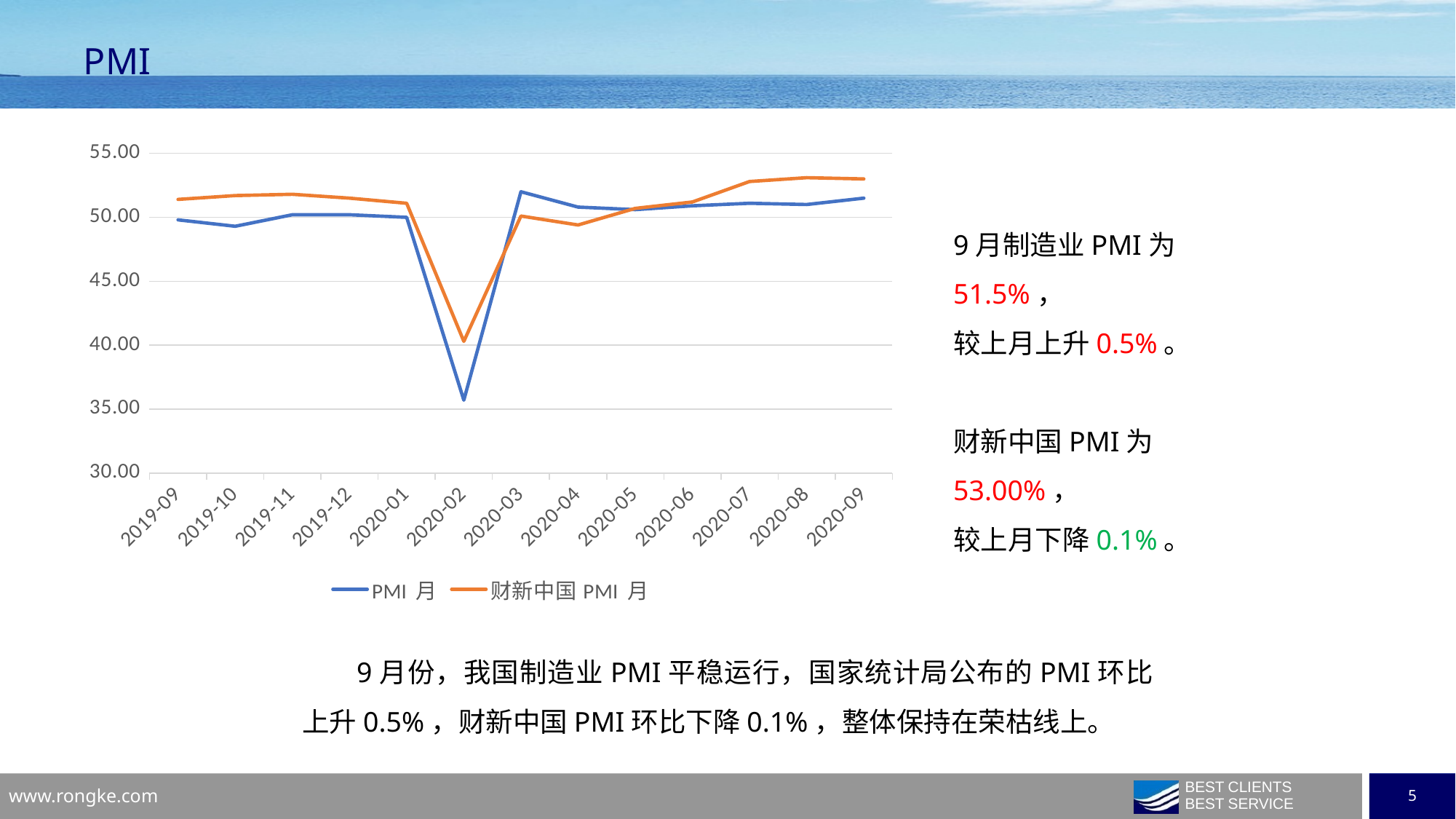
Is the value of 财新中国 PMI 月 in 2020-02 greater or less than 45.00? less Which month has the lowest value for the PMI 月 series? 2020-02 In 2020-02, which series has the higher value, PMI 月 or 财新中国 PMI 月? 财新中国 PMI 月 How many series does the chart legend list? 2 How many months are plotted along the x axis of the chart? 13 Which month has the lowest value for the 财新中国 PMI 月 series? 2020-02 Is the value of PMI 月 in 2019-10 greater or less than 50.00? less In 2020-04, which series has the higher value, PMI 月 or 财新中国 PMI 月? PMI 月 What kind of chart is shown on the slide? line chart Is the value of PMI 月 in 2020-02 greater or less than 40.00? less Does the PMI 月 series rise or fall from 2020-02 to 2020-03? rise